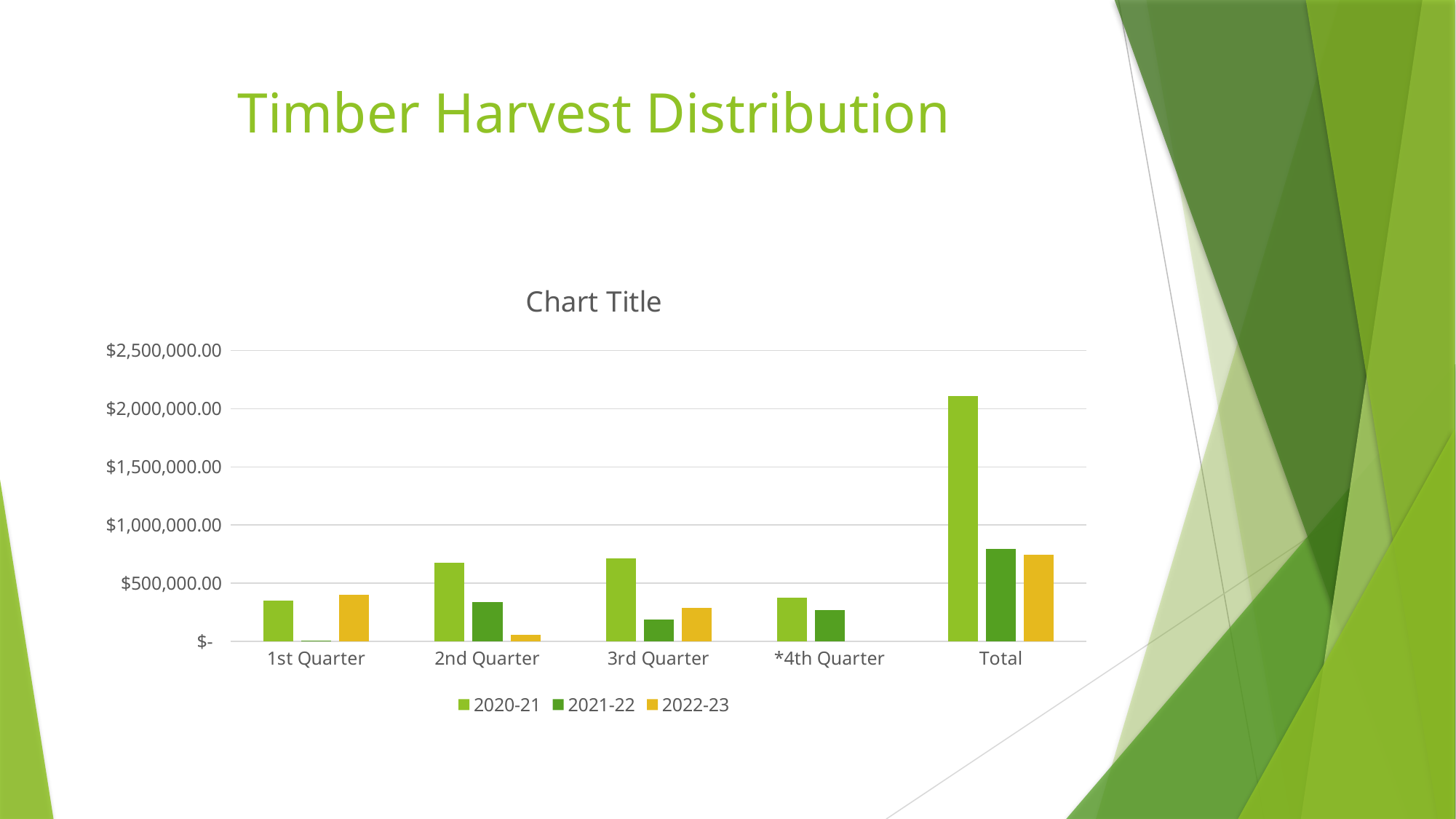
In 2nd Quarter, which series has the larger value, 2020-21 or 2021-22? 2020-21 What are the three series listed in the legend? 2020-21, 2021-22, 2022-23 Which category has the highest value for the 2020-21 series? Total Is the 2021-22 value for 3rd Quarter greater or less than $500,000.00? less How many categories are shown on the x axis? 5 Is the 2020-21 value for 2nd Quarter greater or less than $500,000.00? greater How many series does the legend list? 3 Is the 2020-21 value for Total greater or less than $2,000,000.00? greater Which category has the lowest value for the 2021-22 series? 1st Quarter What kind of chart is shown on the slide? bar chart In 3rd Quarter, which series has the larger value, 2021-22 or 2022-23? 2022-23